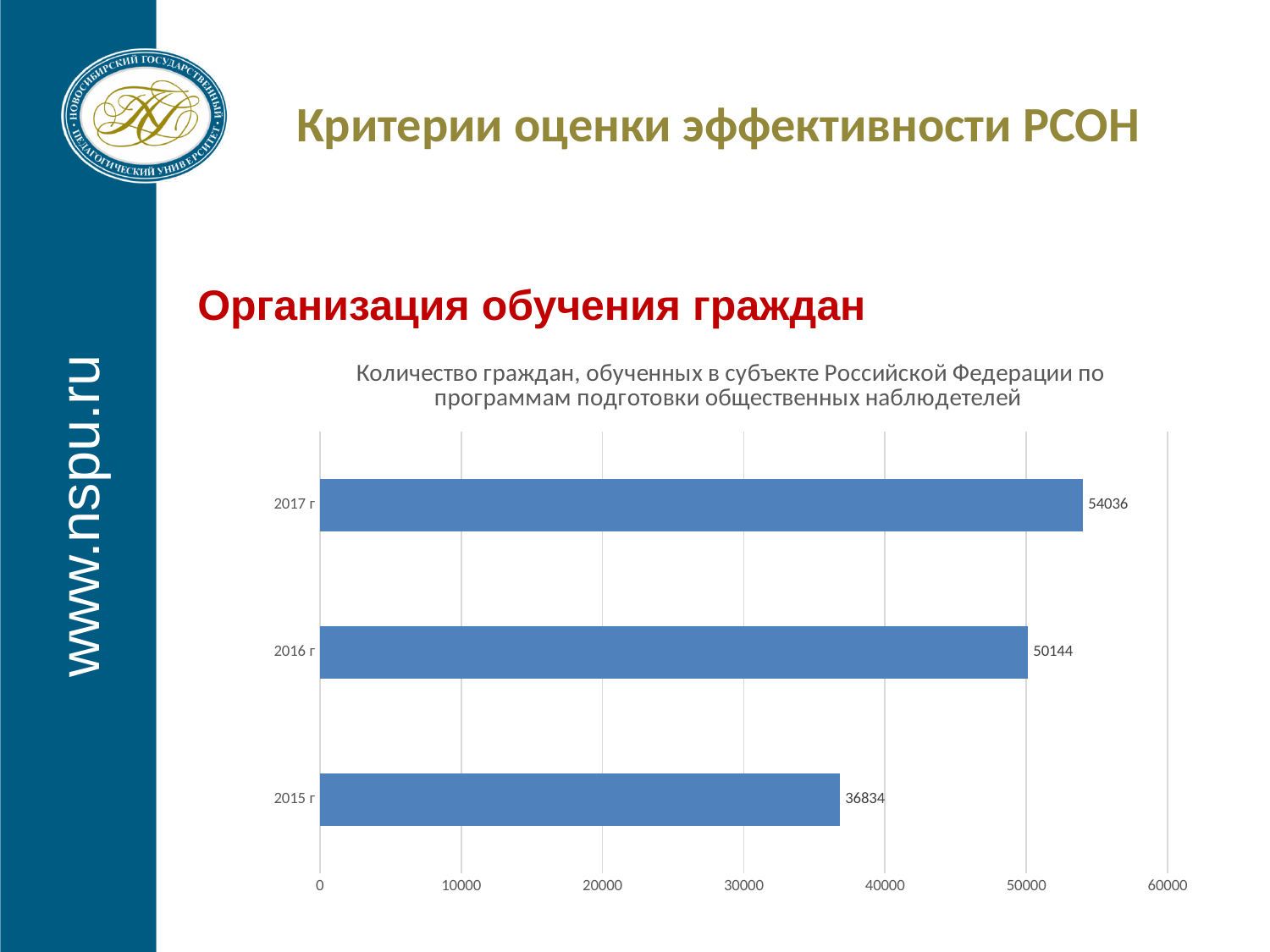
What is the value for 2015 г? 36834 What kind of chart is shown on the slide? bar chart What is the value for 2016 г? 50144 What is the value for 2017 г? 54036 Which year has the highest value? 2017 г Is the value for 2015 г greater or less than 40000? less What is the difference between the values for 2016 г and 2015 г? 13310 Which is larger, the value for 2016 г or the value for 2015 г? 2016 г Do the values rise or fall from 2015 г to 2017 г? rise How many years are shown in the chart? 3 What is the difference between the values for 2017 г and 2016 г? 3892 Which year has the lowest value? 2015 г